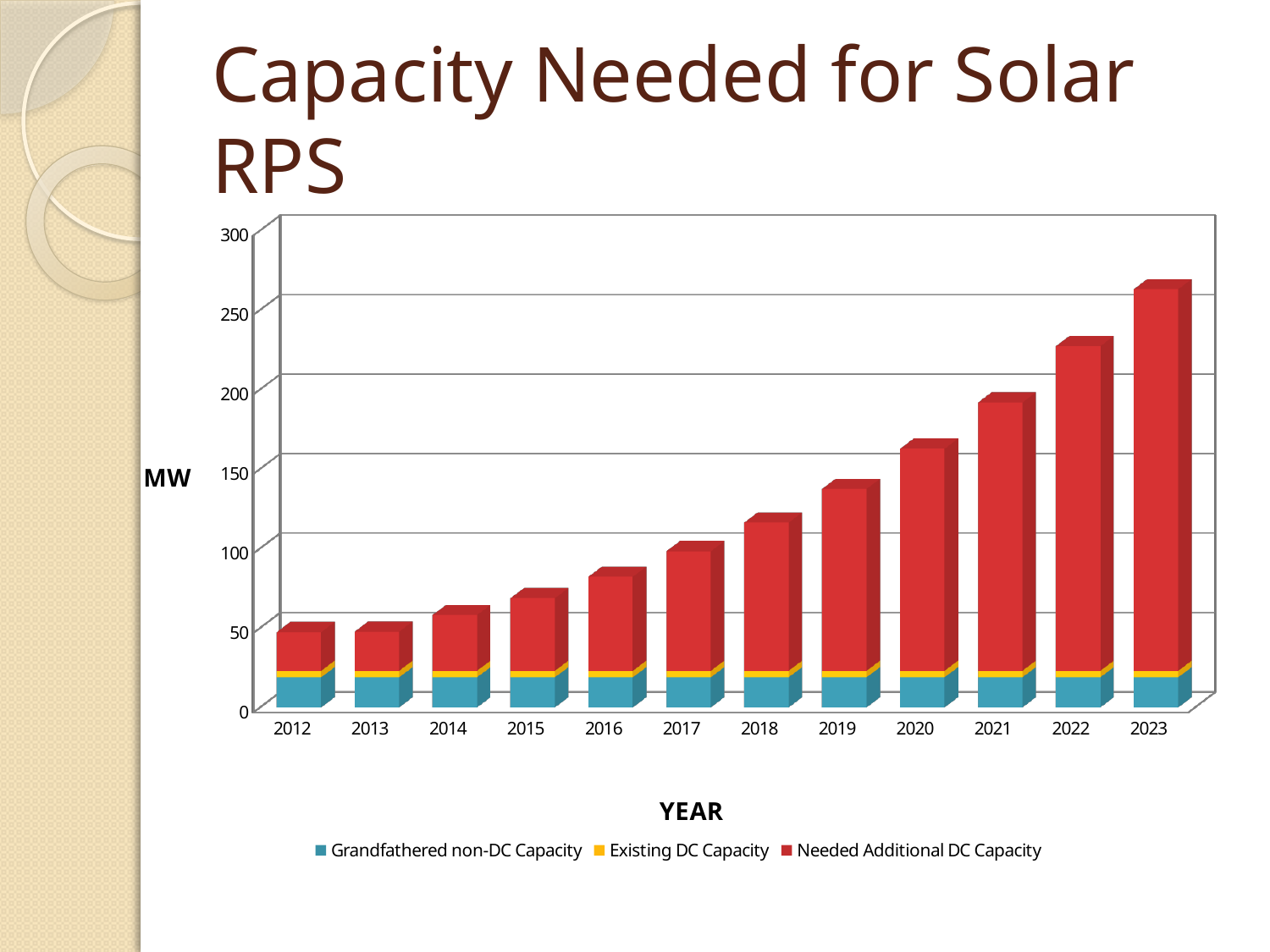
What kind of chart is shown on the slide? bar chart What is the title of the chart on the slide? Capacity Needed for Solar RPS Which series is shown in red in the chart? Needed Additional DC Capacity Is the total capacity for 2016 greater or less than 100? less Which year has the highest total capacity in the chart? 2023 How many series does the chart's legend list? 3 Which year has the larger total capacity, 2015 or 2020? 2020 Is the total capacity for 2022 greater or less than 200? greater Is the total capacity for 2019 greater or less than 150? less Do the total capacity values rise or fall from 2012 to 2023? rise How many years are shown on the x axis of the chart? 12